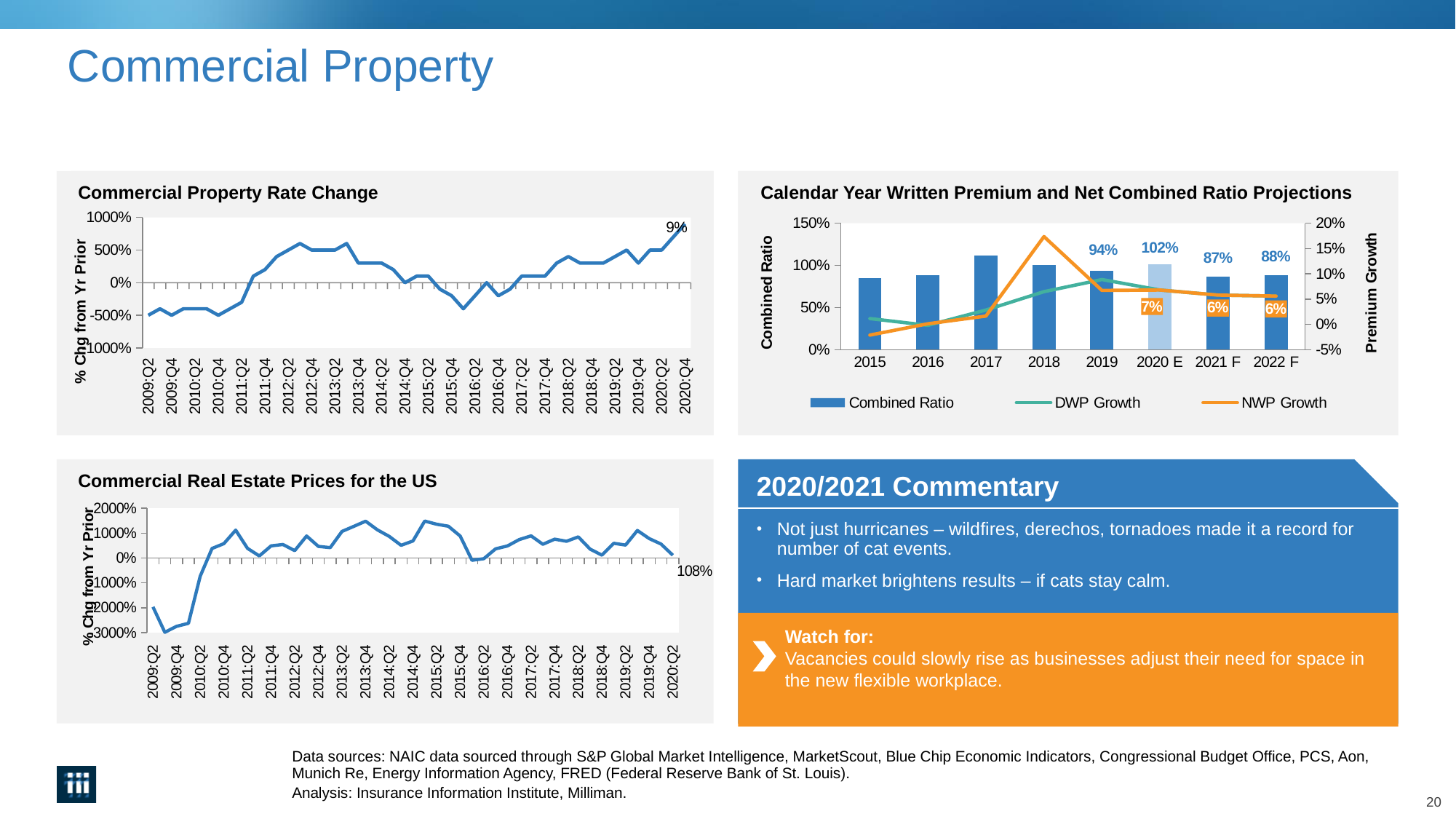
How many series does the legend of the 'Calendar Year Written Premium and Net Combined Ratio Projections' chart list? 3 In the 'Commercial Real Estate Prices for the US' chart, what value is labeled at the last data point? 108% In the 'Calendar Year Written Premium and Net Combined Ratio Projections' chart, what is the combined ratio for 2020 E? 102% In the 'Calendar Year Written Premium and Net Combined Ratio Projections' chart, is the combined ratio for 2015 greater or less than 100%? less In the 'Calendar Year Written Premium and Net Combined Ratio Projections' chart, which has the higher combined ratio, 2021 F or 2022 F? 2022 F In the 'Calendar Year Written Premium and Net Combined Ratio Projections' chart, what is the combined ratio for 2021 F? 87% In the 'Calendar Year Written Premium and Net Combined Ratio Projections' chart, what is the NWP Growth value labeled for 2020 E? 7% In the 'Calendar Year Written Premium and Net Combined Ratio Projections' chart, what is the difference between the combined ratio for 2020 E and 2021 F? 15 percentage points What kind of chart is the 'Commercial Property Rate Change' chart? Line chart How many years are shown on the x axis of the 'Calendar Year Written Premium and Net Combined Ratio Projections' chart? 8 In the 'Commercial Property Rate Change' chart, what value is labeled at the last data point (2020:Q4)? 9% In the 'Calendar Year Written Premium and Net Combined Ratio Projections' chart, which year has the highest combined ratio bar? 2017